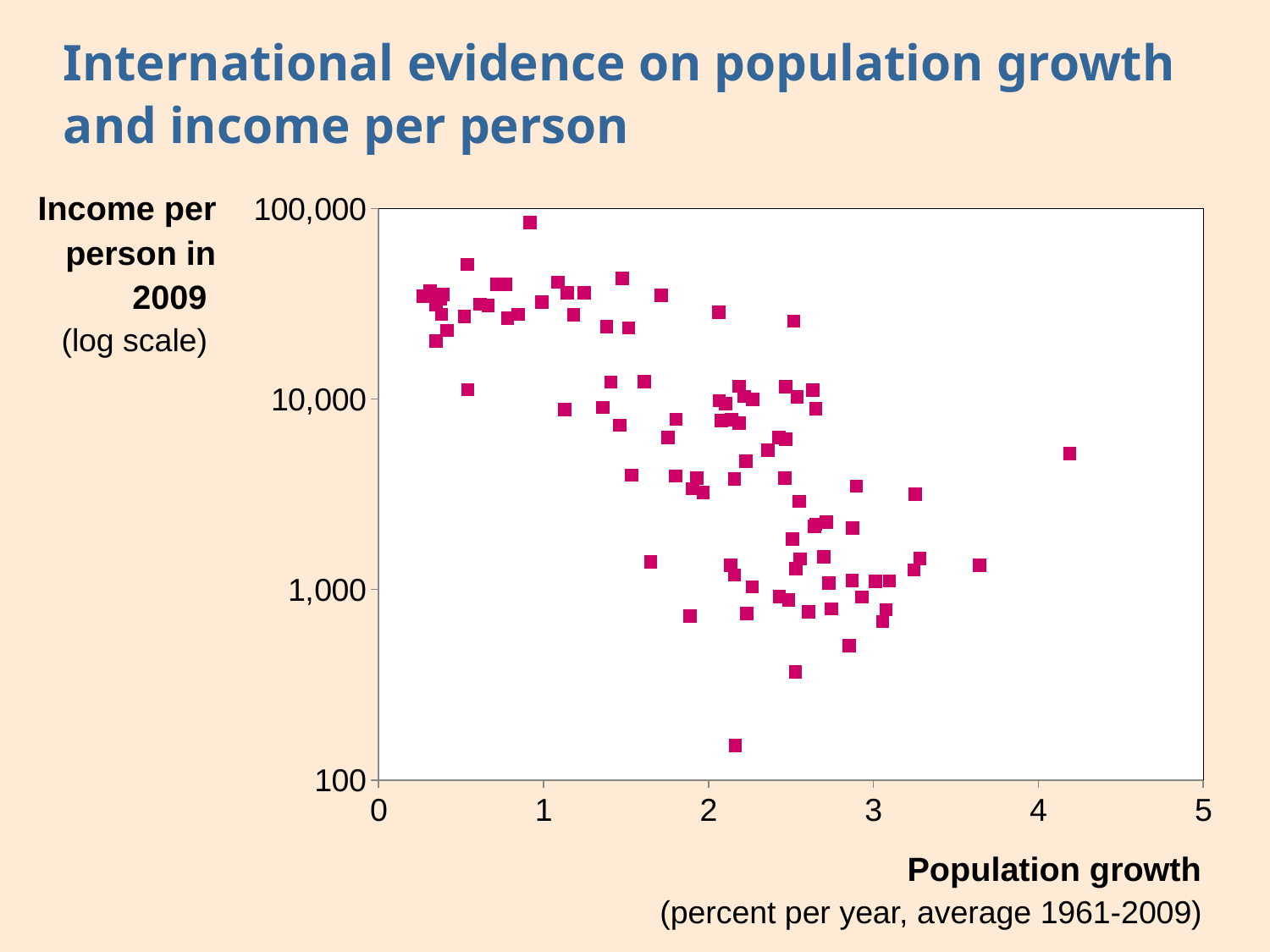
Is the income per person of the point with the smallest population growth greater or less than 10,000? greater As population growth increases along the x axis, do the plotted income per person values generally rise or fall? fall What kind of chart is shown on the slide? scatter plot Is the lowest income per person plotted greater or less than 1,000? less What is the label of the x axis? Population growth (percent per year, average 1961-2009) Is the highest income per person plotted greater or less than 10,000? greater What is the title of the chart on the slide? International evidence on population growth and income per person